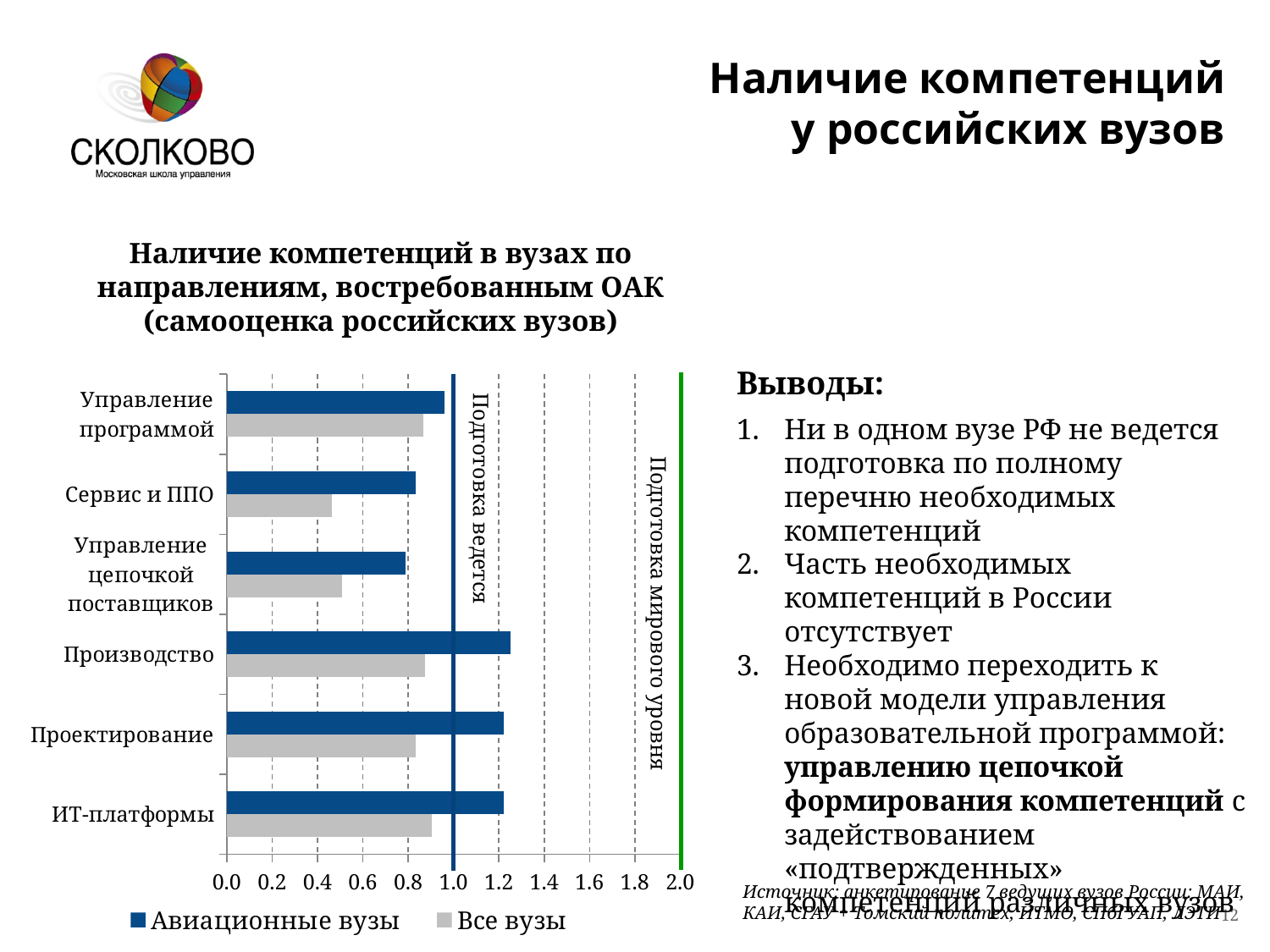
What label is attached to the green vertical line at 2.0 on the chart? Подготовка мирового уровня For Сервис и ППО, which series has the larger value: Авиационные вузы or Все вузы? Авиационные вузы Is the value for Управление программой in the Авиационные вузы series greater or less than 1.0? less For Производство, which series has the larger value: Авиационные вузы or Все вузы? Авиационные вузы What label is attached to the vertical line at 1.0 on the chart? Подготовка ведется What kind of chart is shown on the slide? bar chart Is the value for Управление цепочкой поставщиков in the Все вузы series greater or less than 0.6? less How many categories (directions) are plotted on the chart? 6 Is the value for Производство in the Авиационные вузы series greater or less than 1.0? greater How many series does the chart legend list? 2